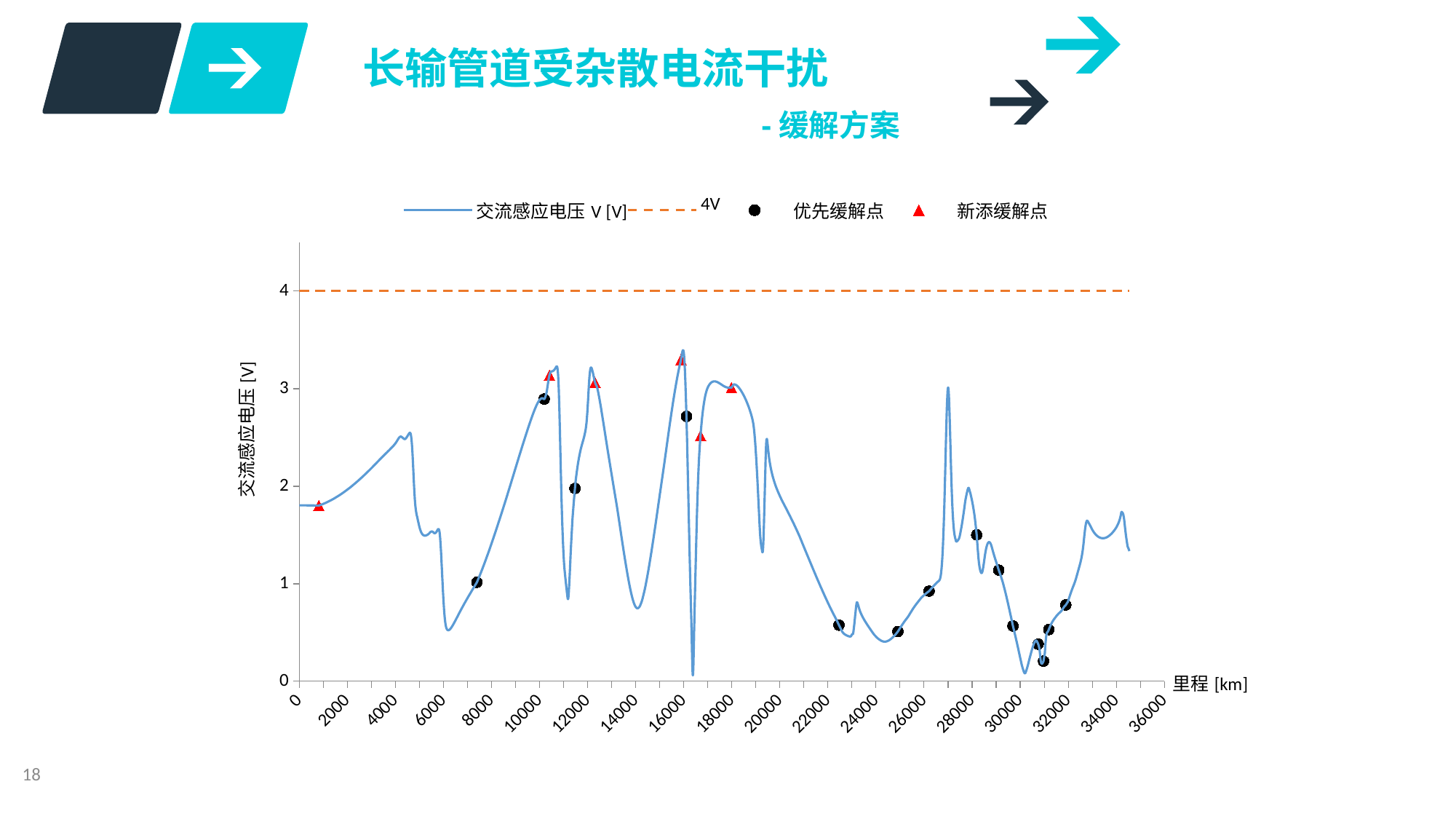
Does the 交流感应电压 curve ever rise above the 4V dashed line? No Is the 交流感应电压 value at 24000 km greater or less than 1? less Does the 交流感应电压 curve rise or fall between 0 km and 4000 km? rise What is the label of the vertical axis? 交流感应电压 [V] How many entries does the chart legend list? 4 How many red triangle markers (新添缓解点) are plotted on the chart? 6 What kind of chart is shown on the slide? line chart Is the 交流感应电压 value at 30000 km greater or less than 1? less At what voltage level is the dashed horizontal reference line drawn? 4V Does the 交流感应电压 curve rise or fall between 18000 km and 24000 km? fall